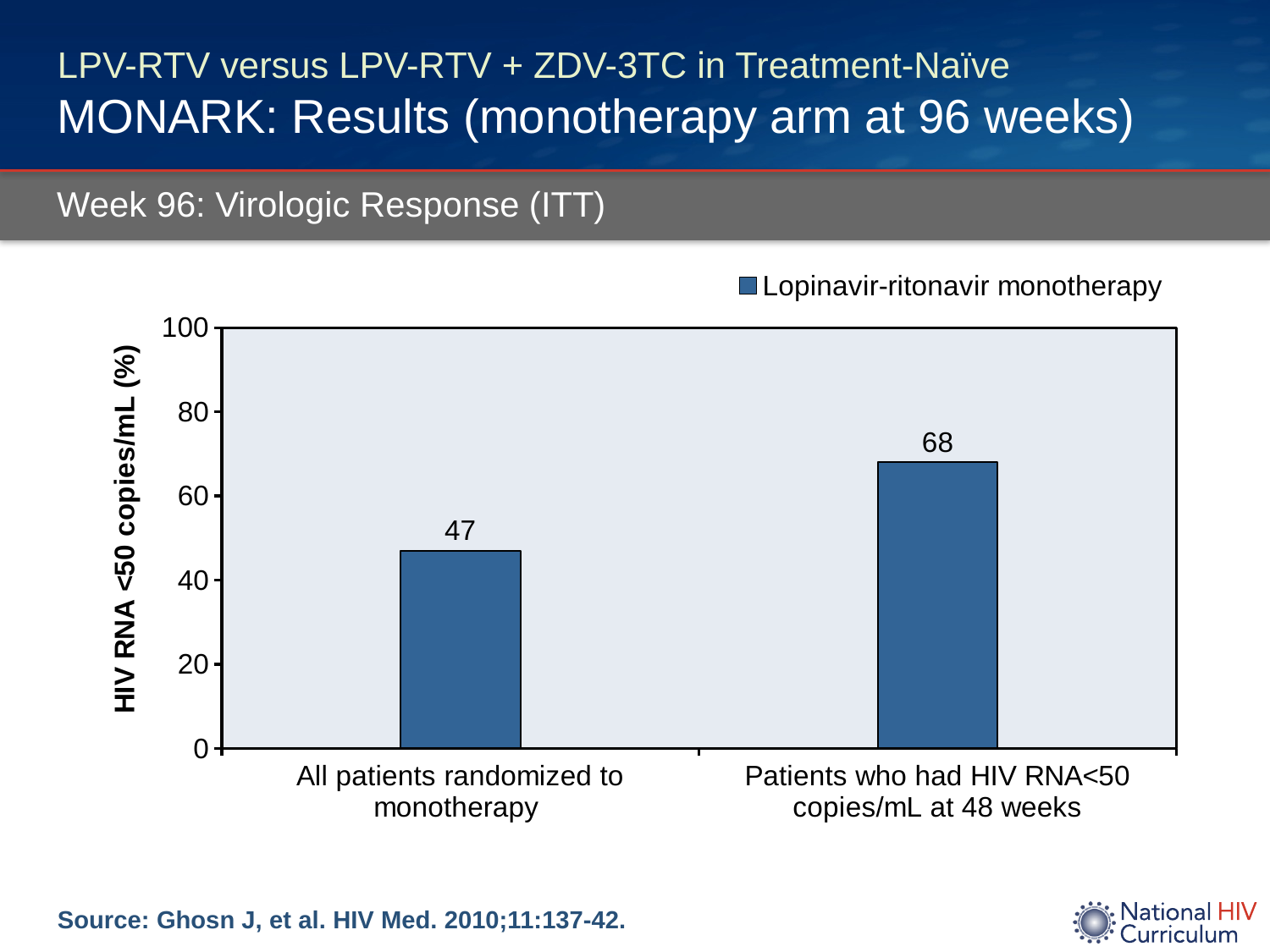
Which category has the lowest value? All patients randomized to monotherapy What is the label of the y axis? HIV RNA <50 copies/mL (%) What is the value for 'All patients randomized to monotherapy'? 47 What is the difference between the value for 'Patients who had HIV RNA<50 copies/mL at 48 weeks' and the value for 'All patients randomized to monotherapy'? 21 Which category has the highest value? Patients who had HIV RNA<50 copies/mL at 48 weeks How many categories are shown on the x axis? 2 What kind of chart is shown? bar chart Which is larger: the value for 'All patients randomized to monotherapy' or the value for 'Patients who had HIV RNA<50 copies/mL at 48 weeks'? Patients who had HIV RNA<50 copies/mL at 48 weeks How many series does the legend list? 1 What is the value for 'Patients who had HIV RNA<50 copies/mL at 48 weeks'? 68 Is the value for 'All patients randomized to monotherapy' greater or less than 60? less Is the value for 'Patients who had HIV RNA<50 copies/mL at 48 weeks' greater or less than 60? greater